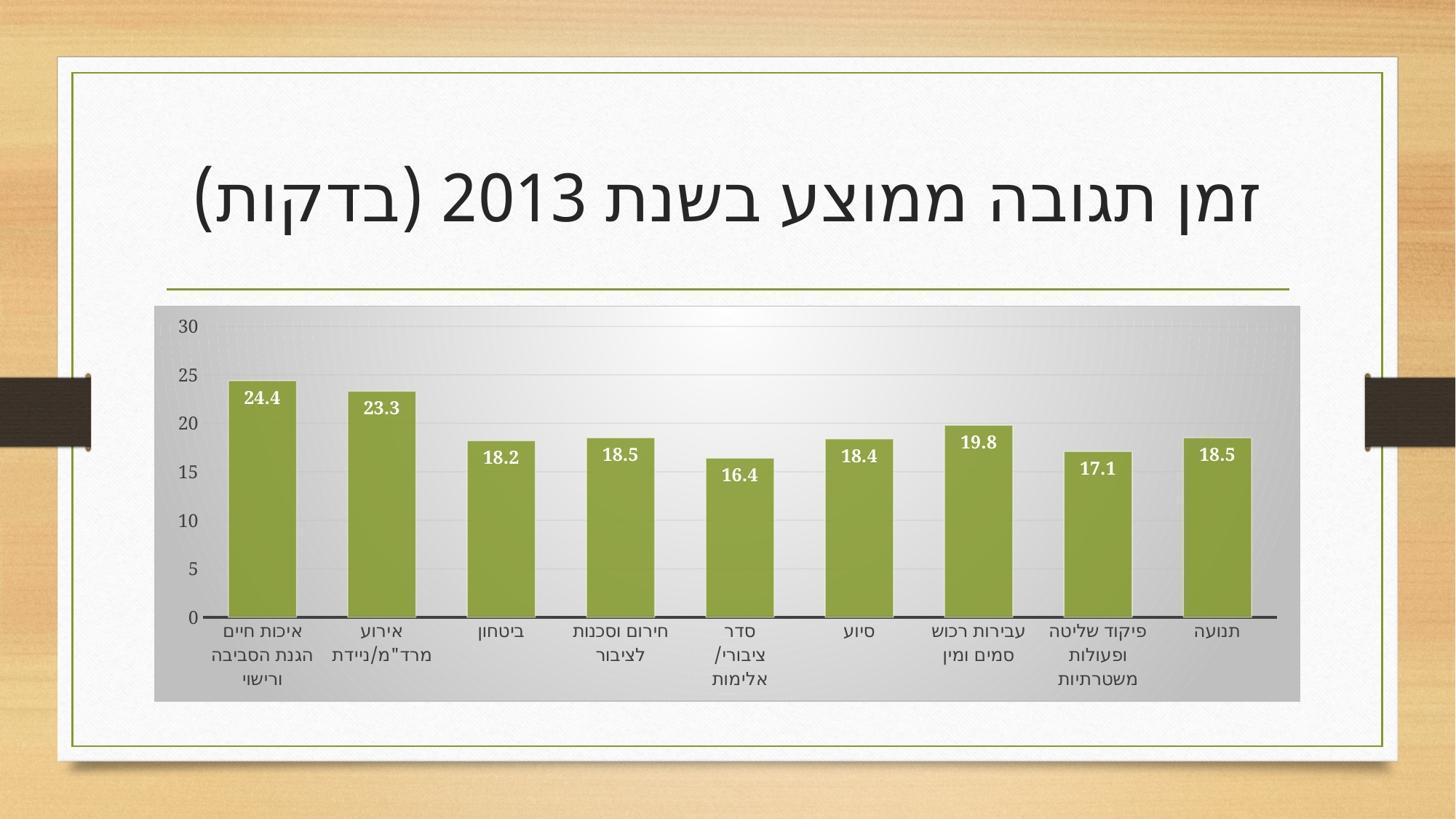
What kind of chart is shown on the slide? bar chart What is the value for תנועה? 18.5 Which category has the highest value? איכות חיים הגנת הסביבה ורישוי Which is larger, the value for סיוע or the value for סדר ציבורי/אלימות? סיוע Which category has the lowest value? סדר ציבורי/אלימות What is the difference between the values for עבירות רכוש סמים ומין and פיקוד שליטה ופעולות משטרתיות? 2.7 What is the value for ביטחון? 18.2 What is the title of the slide? זמן תגובה ממוצע בשנת 2013 (בדקות) Is the value for אירוע מרד"מ/ניידת greater or less than 20? greater What is the value for עבירות רכוש סמים ומין? 19.8 What is the difference between the values for איכות חיים הגנת הסביבה ורישוי and אירוע מרד"מ/ניידת? 1.1 How many categories are shown in the chart? 9